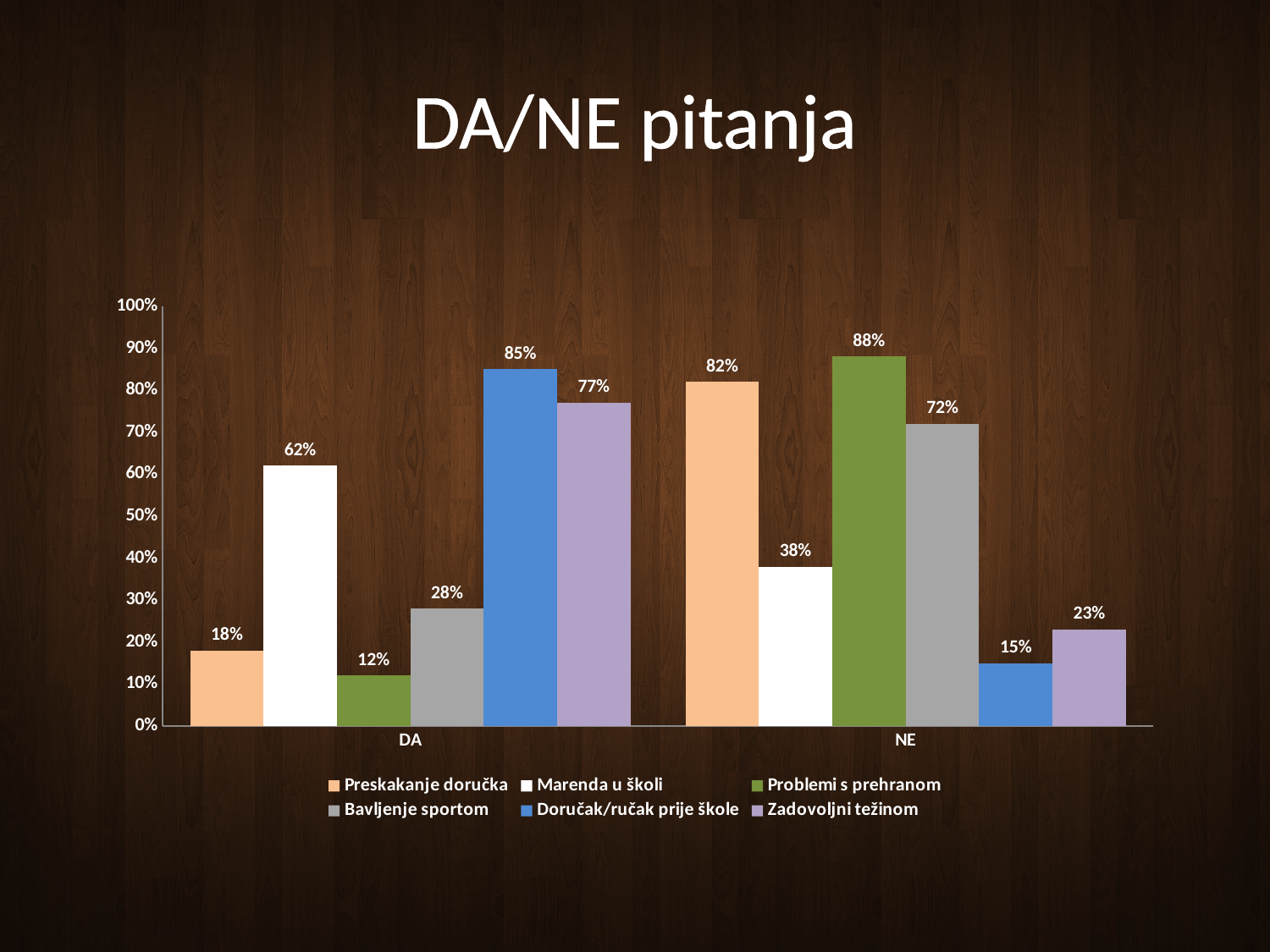
What is the value for Problemi s prehranom in the NE category? 88% What is the value for Doručak/ručak prije škole in the DA category? 85% What is the value for Preskakanje doručka in the DA category? 18% What is the value for Zadovoljni težinom in the NE category? 23% What is the title of the slide? DA/NE pitanja What is the difference between the NE and DA values for Marenda u školi? 24% Which is larger: the DA value for Bavljenje sportom or the NE value for Bavljenje sportom? NE What kind of chart is shown on the slide? Bar chart How many series does the legend list? 6 How many categories are shown on the x axis? 2 Which series has the highest value in the NE category? Problemi s prehranom Which series has the lowest value in the DA category? Problemi s prehranom